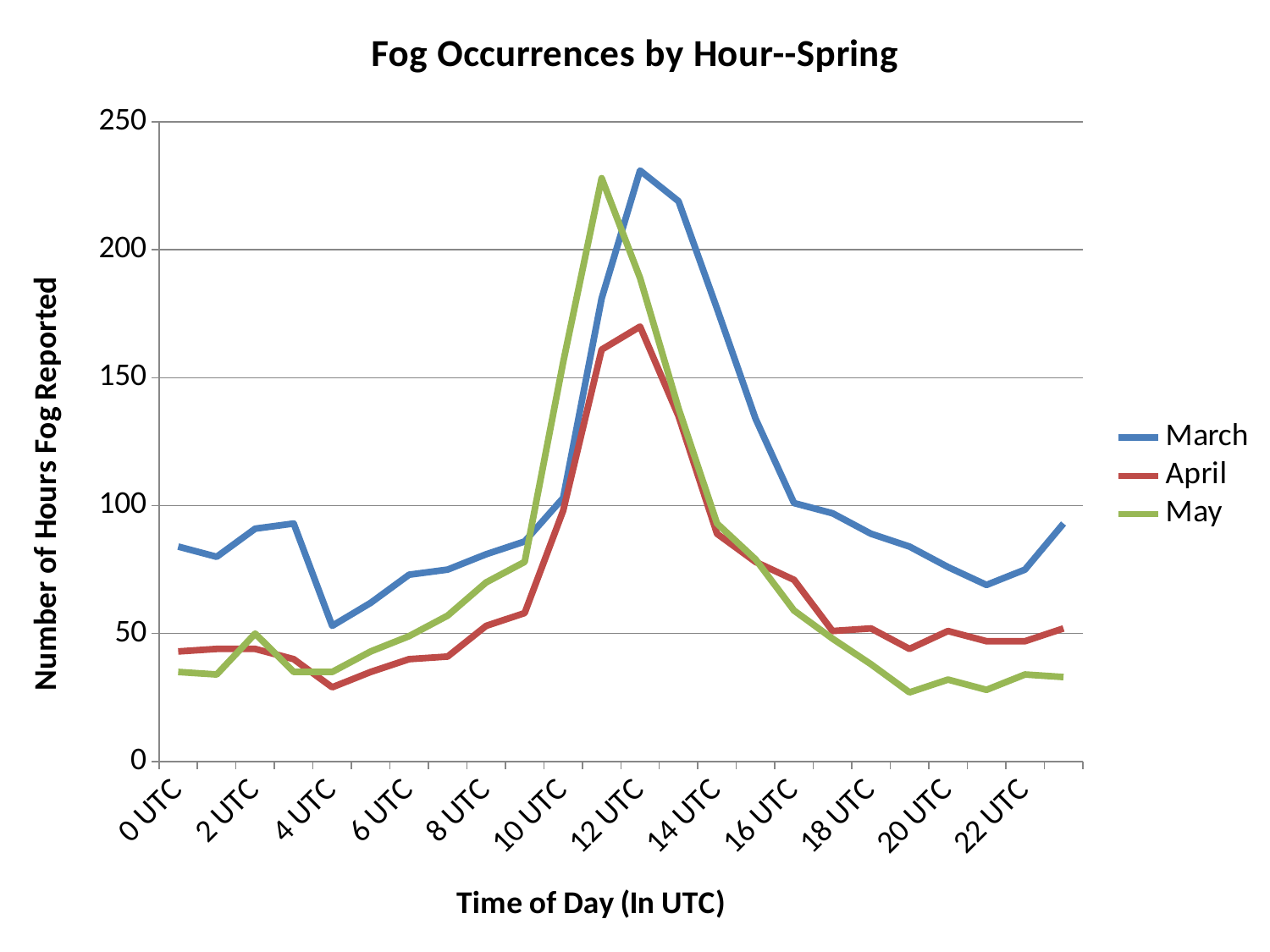
Do the values for March rise or fall from 12 UTC to 22 UTC? fall At 0 UTC, which series has the larger value, March or May? March At 12 UTC, which series has the larger value, March or April? March What is the title of the chart? Fog Occurrences by Hour--Spring Which series has the lowest value at 20 UTC? May Is the value for May at 20 UTC greater or less than 50? less Is the value for March at 22 UTC greater or less than 100? less Is the value for April at 12 UTC greater or less than 150? greater What kind of chart is shown on the slide? line chart How many series does the legend list? 3 Which months are listed in the legend? March, April, May